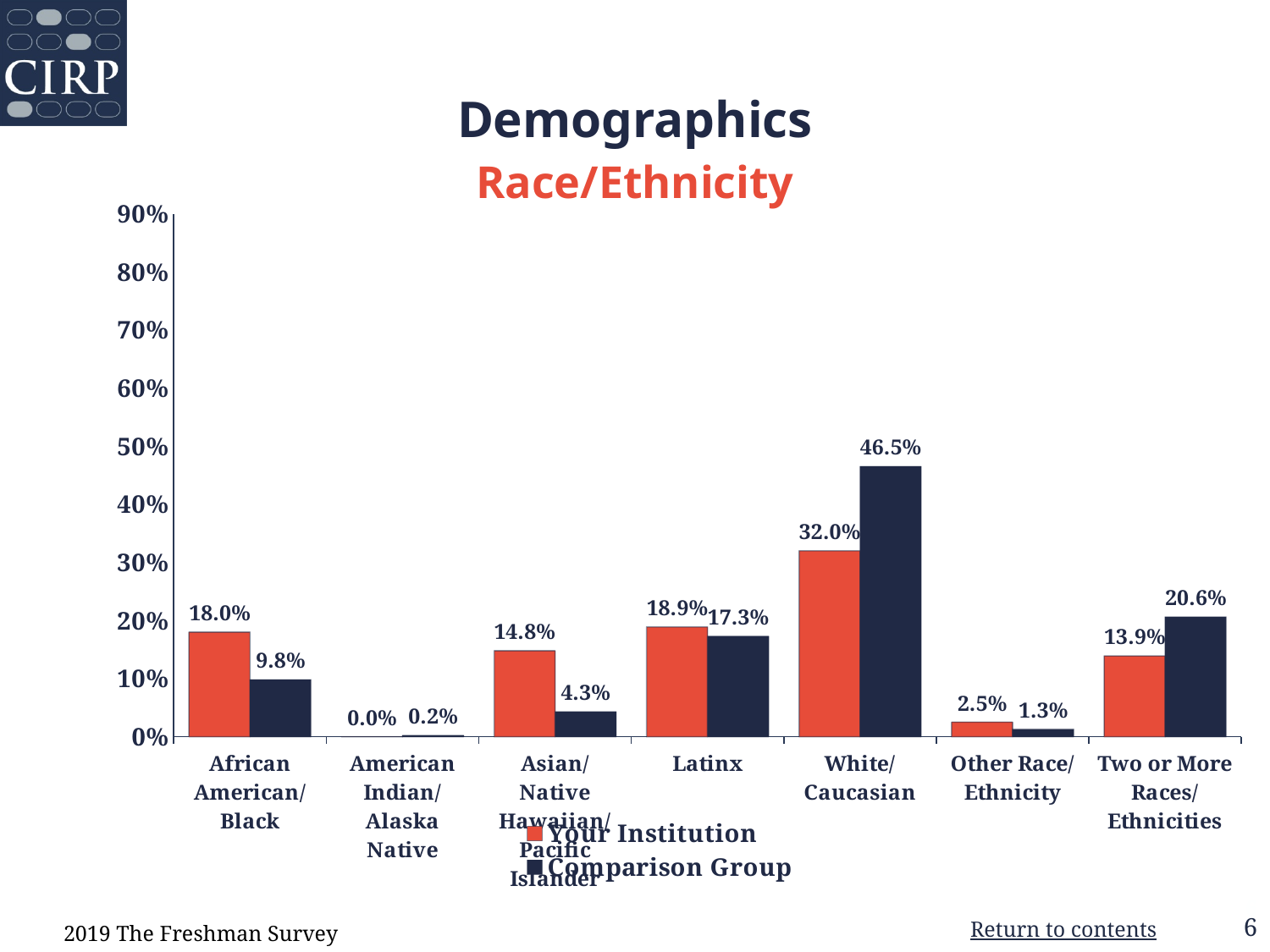
For Two or More Races/Ethnicities, which series has the larger value? Comparison Group How many race/ethnicity categories are shown on the x axis? 7 What is the Your Institution value for White/Caucasian? 32.0% What is the Your Institution value for Asian/Native Hawaiian/Pacific Islander? 14.8% What is the difference between the Comparison Group and Your Institution values for White/Caucasian? 14.5% Which category has the highest Comparison Group value? White/Caucasian Which category has the lowest Your Institution value? American Indian/Alaska Native What is the difference between the Your Institution and Comparison Group values for Latinx? 1.6% Is the Comparison Group value for White/Caucasian greater or less than 40%? greater How many series does the legend list? 2 What type of chart is shown on the slide? Bar chart What is the Comparison Group value for African American/Black? 9.8%